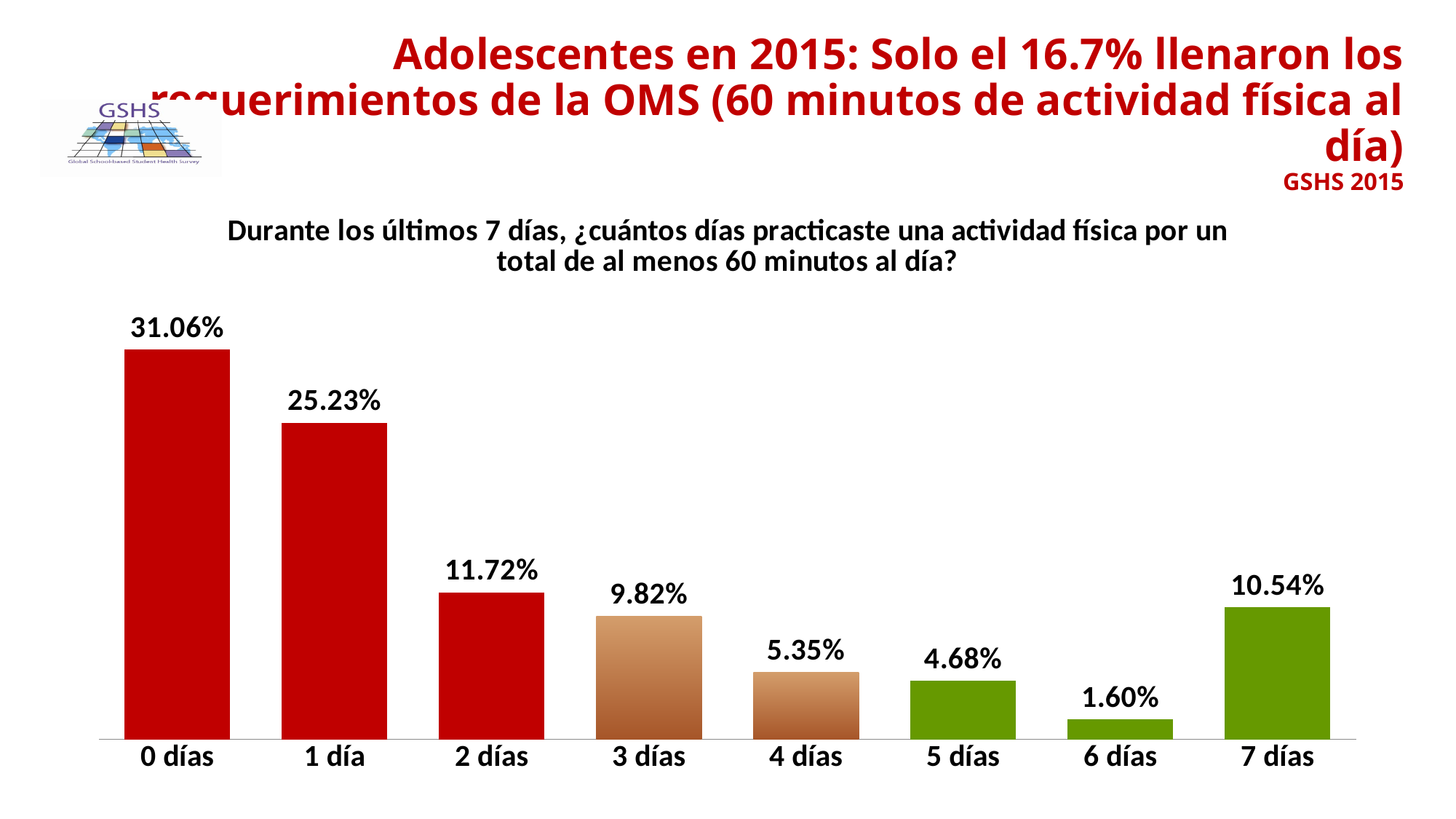
Do the values rise or fall from 0 días to 6 días? Fall What is the difference between the values for 0 días and 1 día? 5.83% What is the value for 0 días? 31.06% Which category has the highest value? 0 días What is the value for 7 días? 10.54% Which category has the lowest value? 6 días What kind of chart is shown on the slide? Bar chart What is the value for 4 días? 5.35% What colour are the bars for 5 días, 6 días and 7 días? Green How many categories are shown on the x axis? 8 Which is larger, the value for 3 días or the value for 7 días? 7 días What is the difference between the values for 7 días and 6 días? 8.94%